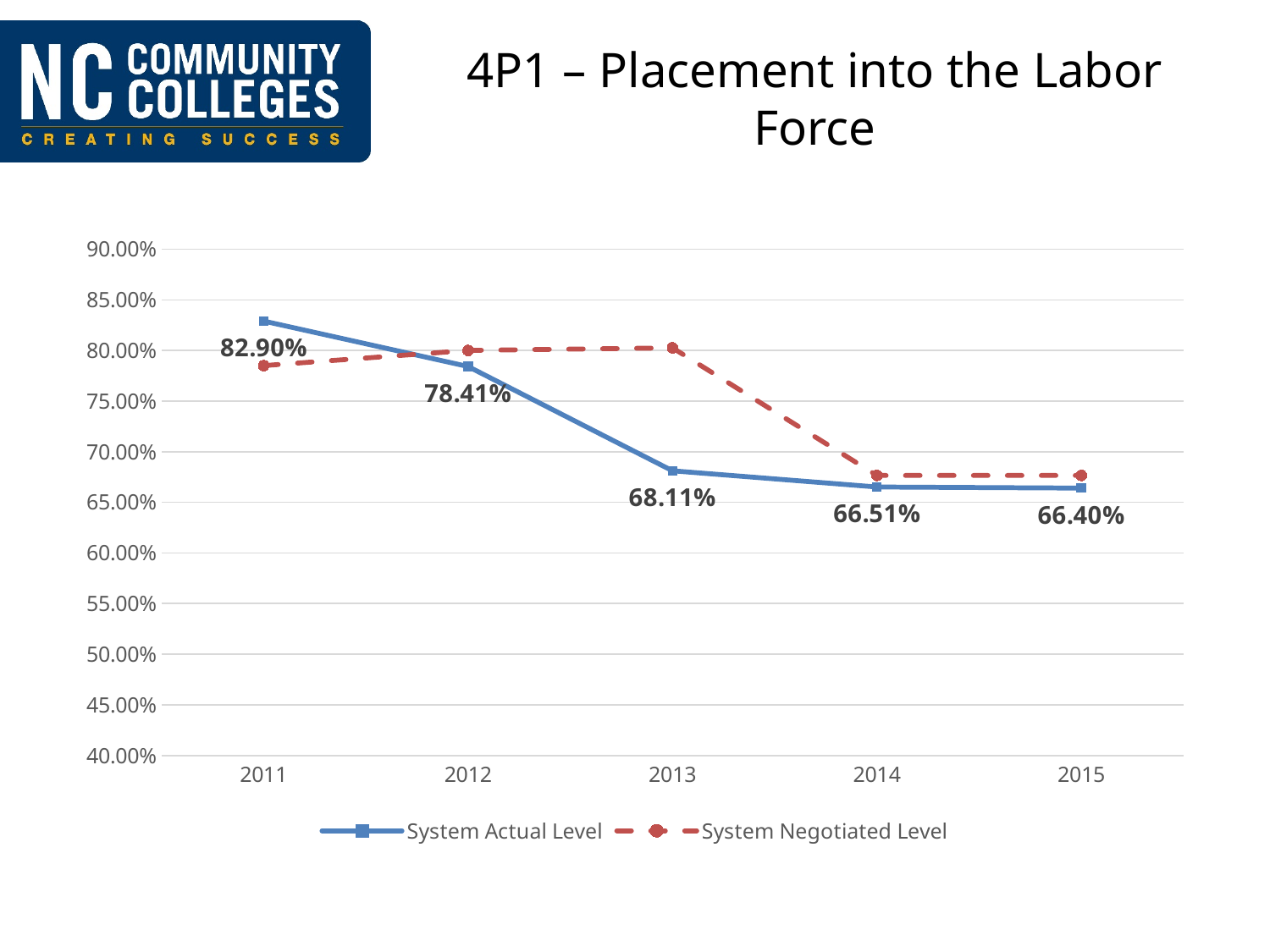
Is the System Negotiated Level value for 2011 greater or less than 80.00%? less In which year is the System Actual Level lowest? 2015 In which year is the System Actual Level highest? 2011 In 2013, which series has the higher value, System Actual Level or System Negotiated Level? System Negotiated Level How many years are shown on the x axis? 5 Is the System Negotiated Level value for 2014 greater or less than 70.00%? less What is the difference between the System Actual Level in 2012 and in 2013? 10.30% What is the difference between the System Actual Level in 2011 and in 2012? 4.49% How many series does the legend list? 2 What is the System Actual Level value for 2015? 66.40% What is the System Actual Level value for 2011? 82.90% What is the System Actual Level value for 2013? 68.11%